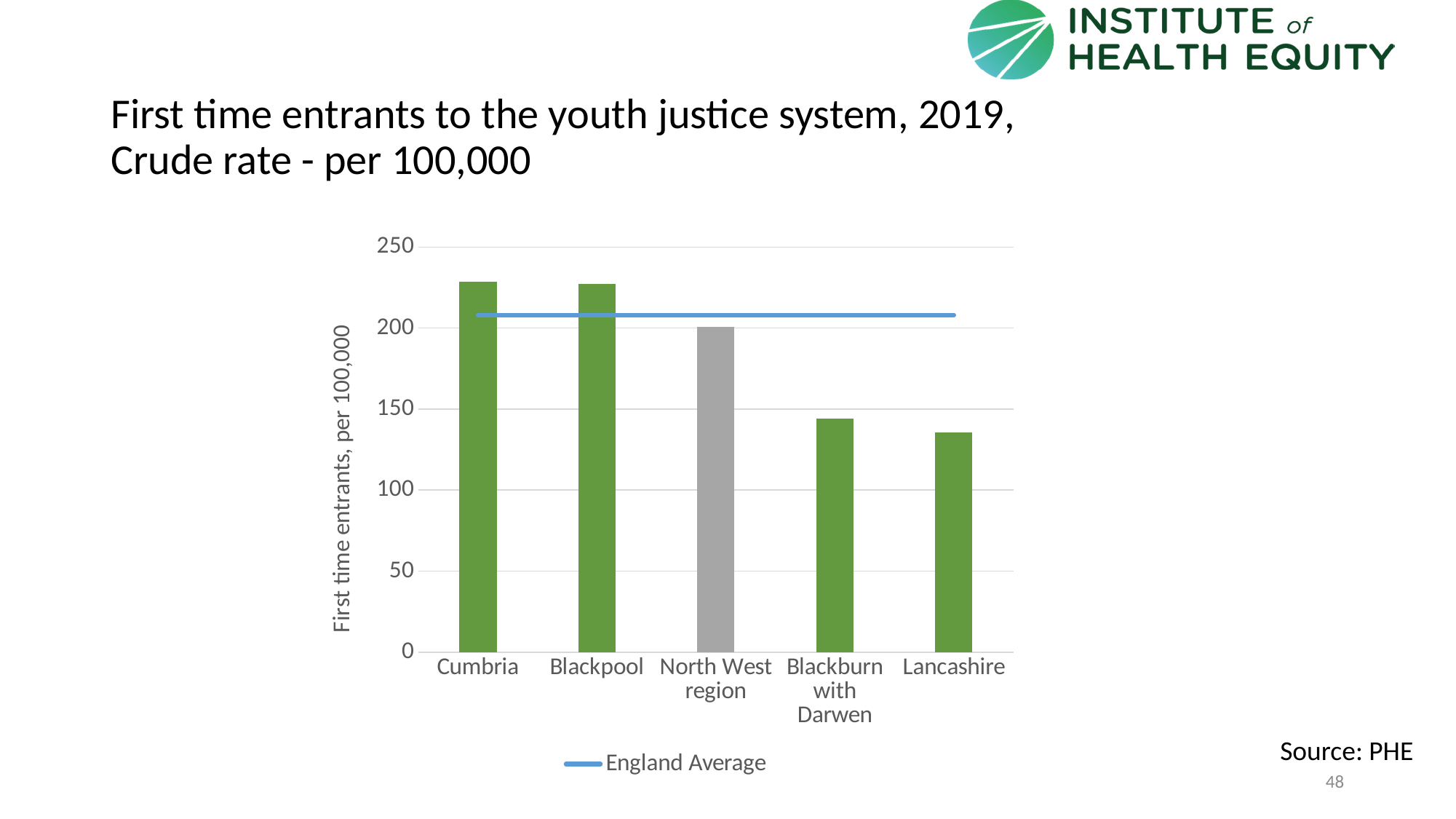
Is the value for Lancashire greater or less than 150? less Do the bar values generally rise or fall from left to right along the x axis? Fall Is the value for North West region greater or less than 150? greater How many categories are shown on the x axis of the chart? 5 What is the label on the vertical axis of the chart? First time entrants, per 100,000 Is the value for Blackburn with Darwen greater or less than 150? less What series does the legend of the chart list? England Average Which is larger, the value for Blackpool or the value for Blackburn with Darwen? Blackpool Which category has the lowest value in the chart? Lancashire What kind of chart is shown on the slide? Bar and line chart How many series does the chart's legend list? 1